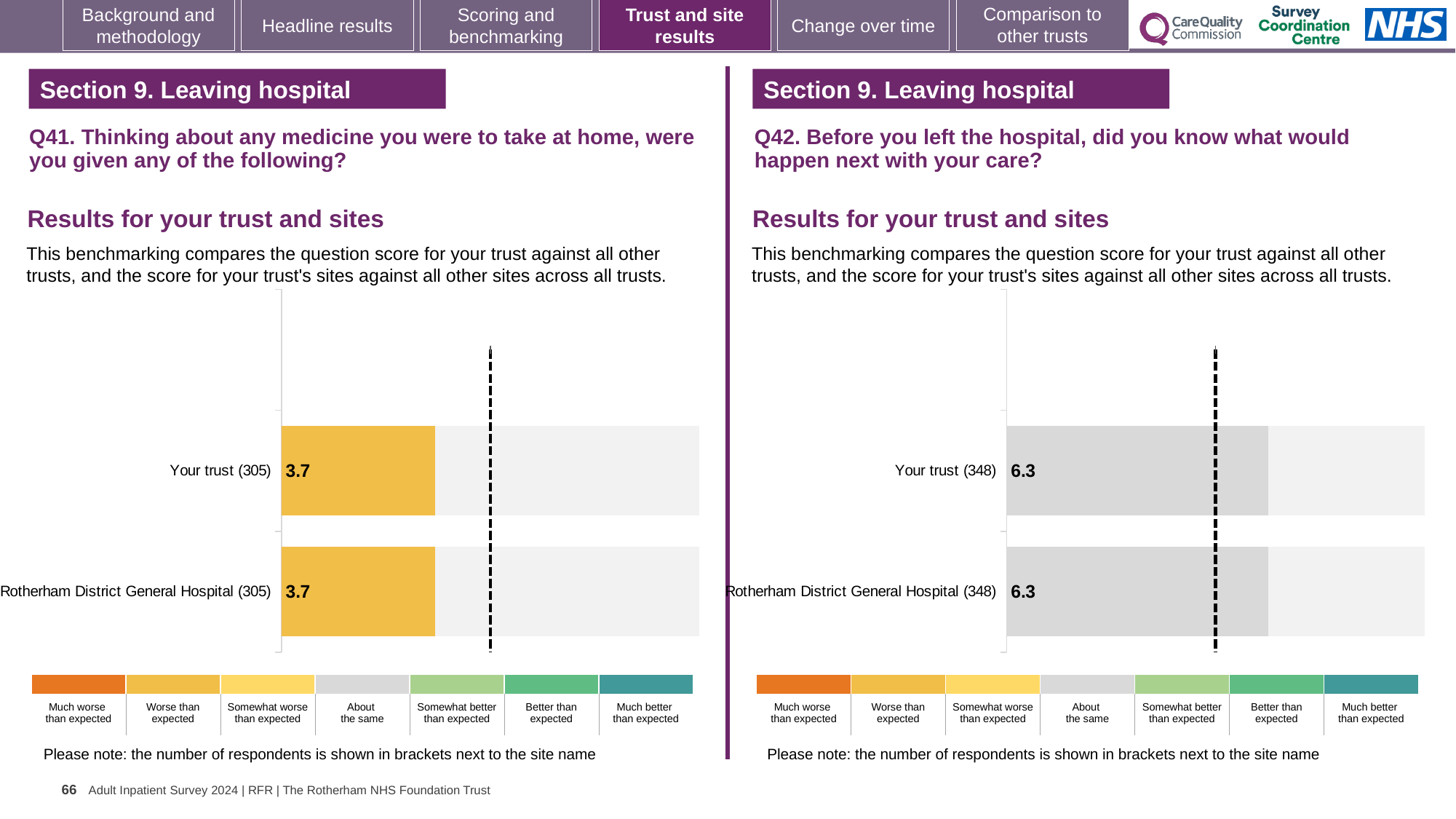
In the Q42 chart on the right, which benchmark category does the colour of the bars correspond to according to the legend? About the same In the Q42 chart on the right, how many bars are plotted? 2 What kind of chart is used in the Q41 chart on the left? Bar chart In the Q42 chart on the right, how many respondents are shown in brackets for Rotherham District General Hospital? 348 In the Q42 chart on the right, what is the score for Your trust? 6.3 In the Q41 chart on the left, how many respondents are shown in brackets for Your trust? 305 In the Q42 chart on the right, what is the score for Rotherham District General Hospital? 6.3 In the Q41 chart on the left, what is the score for Your trust? 3.7 In the Q41 chart on the left, what is the score for Rotherham District General Hospital? 3.7 In the Q41 chart on the left, which benchmark category does the colour of the bars correspond to according to the legend? Worse than expected In the Q41 chart on the left, what is the difference between the score for Your trust and the score for Rotherham District General Hospital? 0 Is the score for Your trust in the Q42 chart on the right larger or smaller than the score for Your trust in the Q41 chart on the left? Larger